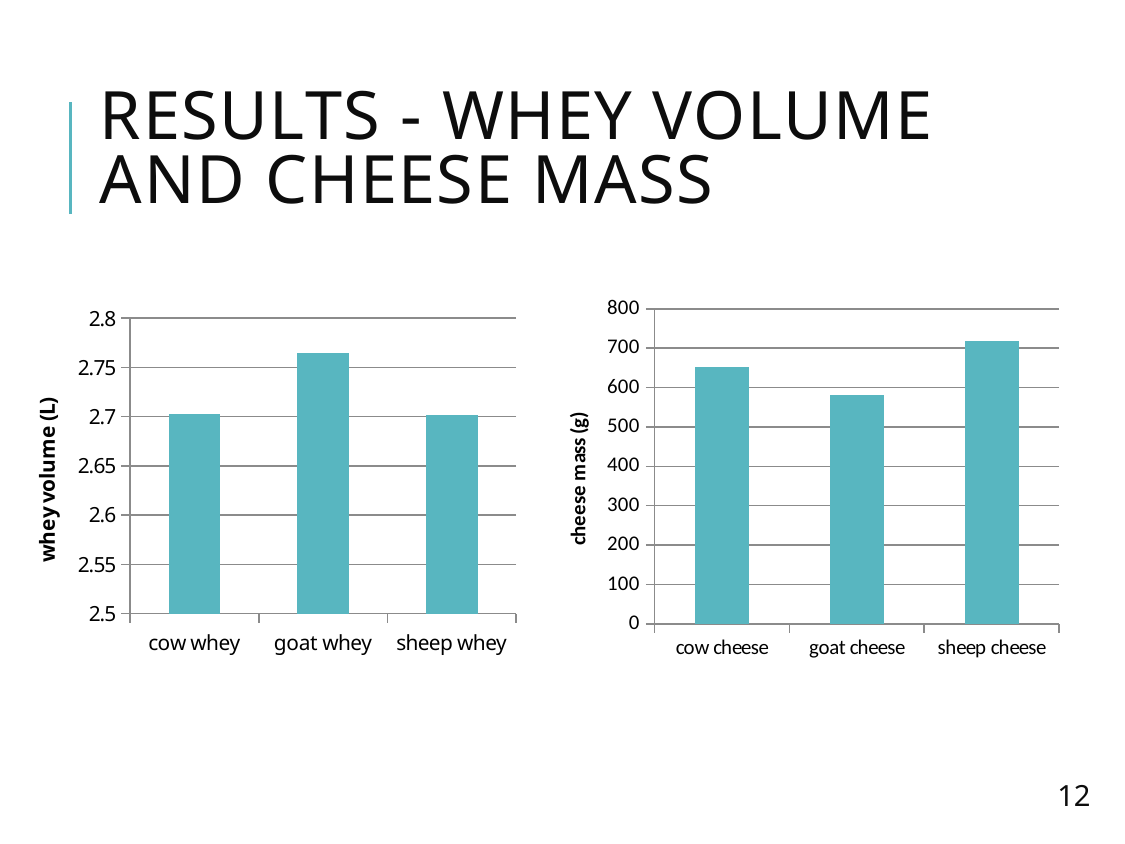
In the left chart (whey volume), is the value for goat whey greater or less than 2.7? greater How many categories are shown in the left chart (whey volume)? 3 In the right chart (cheese mass), is the value for goat cheese greater or less than 600? less How many categories are shown in the right chart (cheese mass)? 3 What is the y-axis label of the right chart? cheese mass (g) What is the y-axis label of the left chart? whey volume (L) What kind of chart is the left chart showing whey volume? bar chart In the right chart (cheese mass), which is larger, cow cheese or goat cheese? cow cheese In the right chart (cheese mass), which category has the lowest value? goat cheese In the right chart (cheese mass), which category has the highest value? sheep cheese In the left chart (whey volume), which category has the highest value? goat whey In the left chart (whey volume), is the value for cow whey greater or less than 2.65? greater